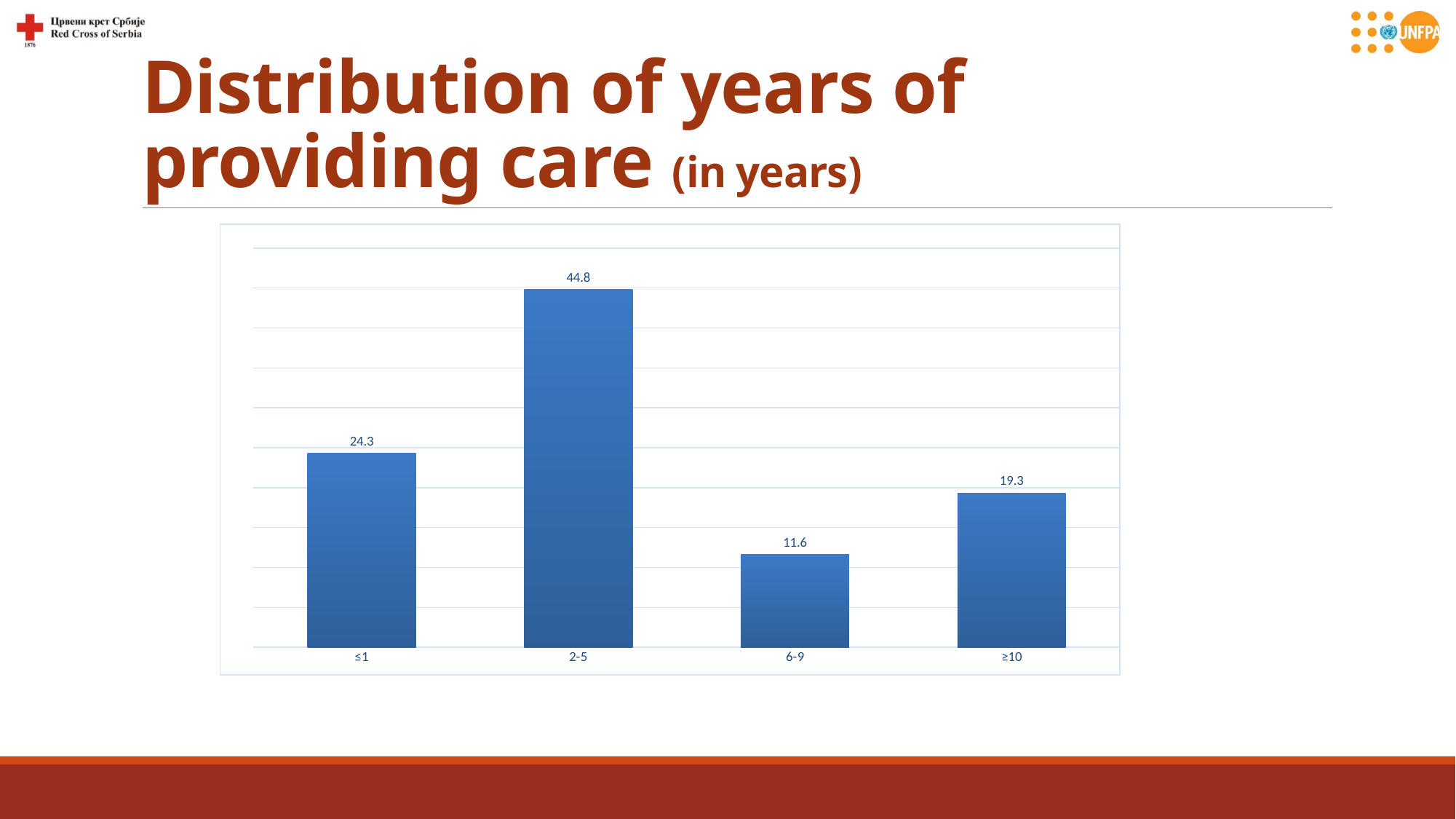
What is the value for the 6-9 years category? 11.6 Which is larger, the value for ≤1 or the value for ≥10? ≤1 What is the difference between the values for ≥10 and 6-9? 7.7 How many categories are shown on the x axis? 4 Which category has the lowest value? 6-9 What kind of chart is shown on the slide? Bar chart What is the title of the slide containing the chart? Distribution of years of providing care (in years) What is the value for the ≥10 years category? 19.3 What is the value for the ≤1 years category? 24.3 Which category has the highest value? 2-5 What is the value for the 2-5 years category? 44.8 What is the difference between the values for 2-5 and ≤1? 20.5